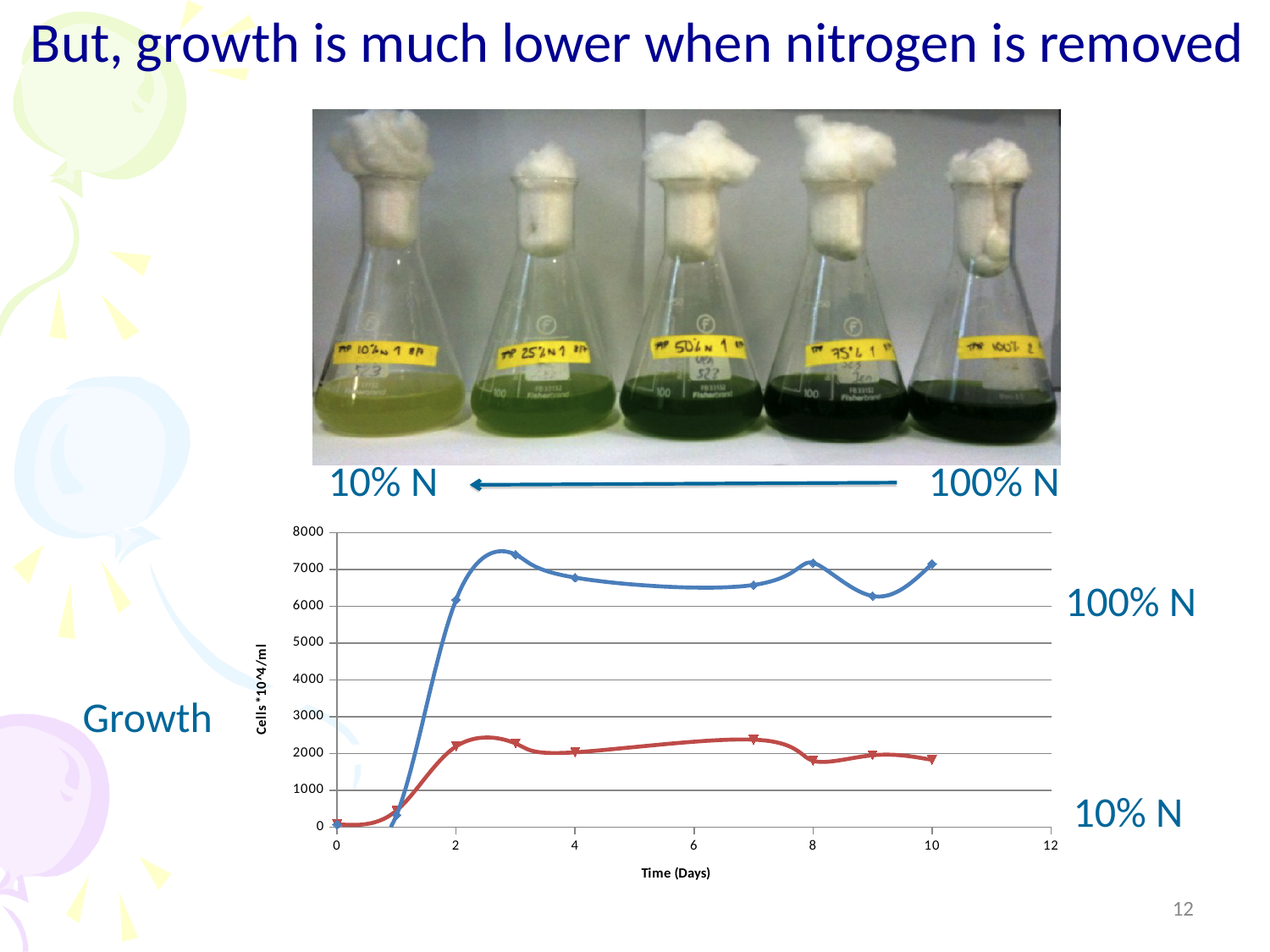
Is the value for 100% N at day 3 greater or less than 7000? greater At day 4, which series has the larger value, 100% N or 10% N? 100% N What kind of chart is shown on the slide? line chart What is the label of the x axis on the growth chart? Time (Days) What is the label of the y axis on the growth chart? Cells *10^4/ml Which series reaches the higher cell counts, 100% N or 10% N? 100% N How many series are plotted on the growth chart? 2 Is the value for 10% N at day 8 greater or less than 2000? less Is the value for 10% N at day 7 greater or less than 3000? less Does the 10% N series rise or fall between day 7 and day 8? fall Does the 100% N series rise or fall between day 0 and day 3? rise